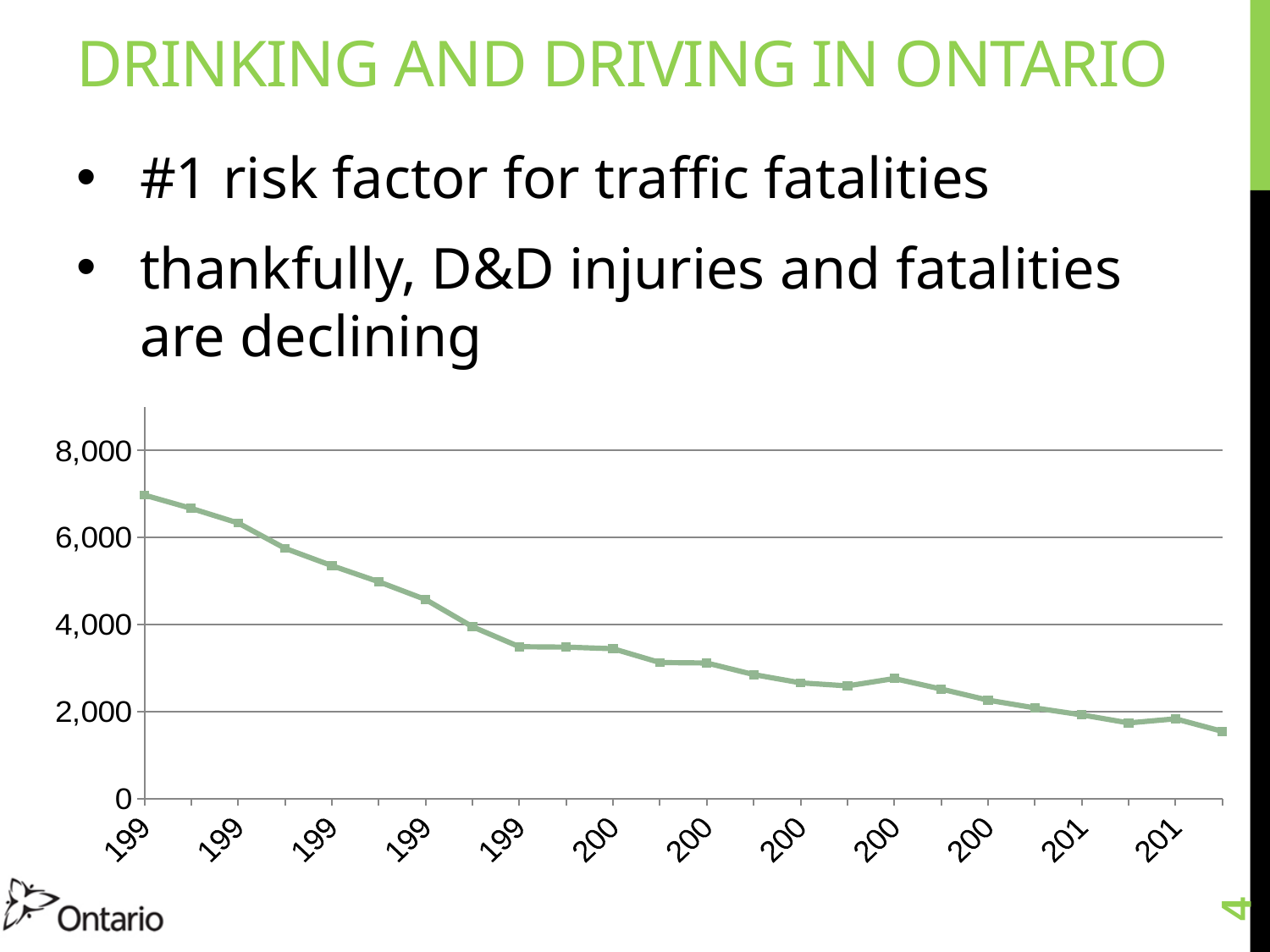
Which point on the line has the highest value, the leftmost or the rightmost? leftmost Is the value of the first (leftmost) point on the line greater or less than 6,000? greater Which is larger, the value of the first point on the line or the value of the last point? the first point What kind of chart is shown on the slide? line chart What is the highest value labelled on the y axis of the chart? 8,000 How many data points are plotted on the line? 24 Do the values in the chart generally rise or fall from left to right along the x axis? fall Is the value of the first (leftmost) point on the line greater or less than 8,000? less Which point on the line has the lowest value, the leftmost or the rightmost? rightmost Is the value of the last (rightmost) point on the line greater or less than 1,000? greater What colour is the line in the chart? green